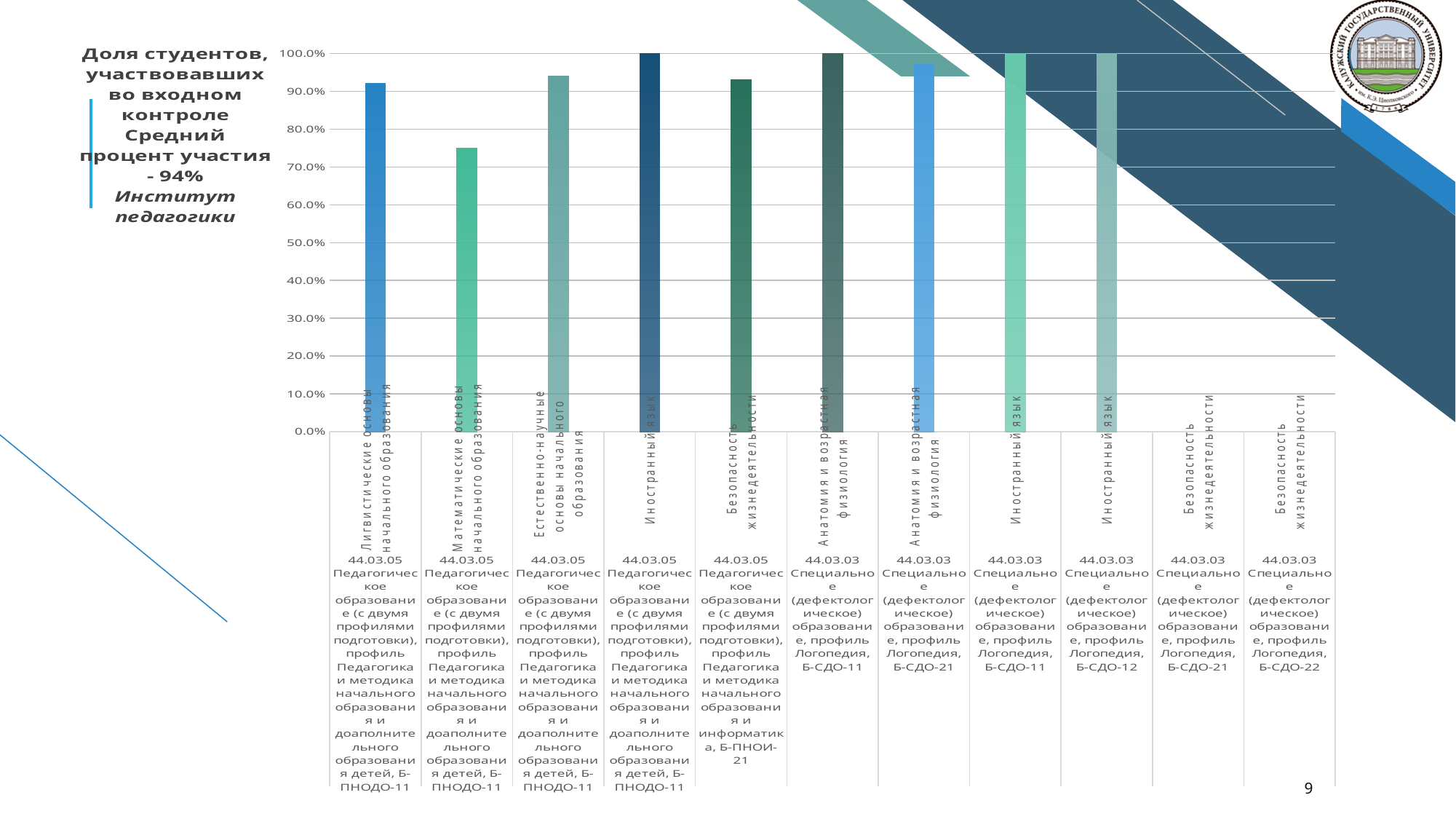
Which is larger: the value for Лингвистические основы начального образования (Б-ПНОДО-11) or for Математические основы начального образования (Б-ПНОДО-11)? Лингвистические основы начального образования Is the value for Математические основы начального образования (Б-ПНОДО-11) greater or less than 80.0%? less What is the value for Анатомия и возрастная физиология in group 44.03.03, Б-СДО-11? 100.0% What kind of chart is shown on the slide? bar chart What is the value for Иностранный язык in group 44.03.05, Б-ПНОДО-11? 100.0% What is the value for Иностранный язык in group 44.03.03, Б-СДО-12? 100.0% Among the categories with a visible bar, which has the lowest value? Математические основы начального образования (Б-ПНОДО-11) How many bars reach the 100.0% line? 4 What average participation percentage is stated in the chart title text? 94% Is the value for Естественно-научные основы начального образования (Б-ПНОДО-11) greater or less than 90.0%? greater How many categories are listed along the x axis of the chart? 11 Is the value for Анатомия и возрастная физиология (Б-СДО-21) greater or less than 90.0%? greater